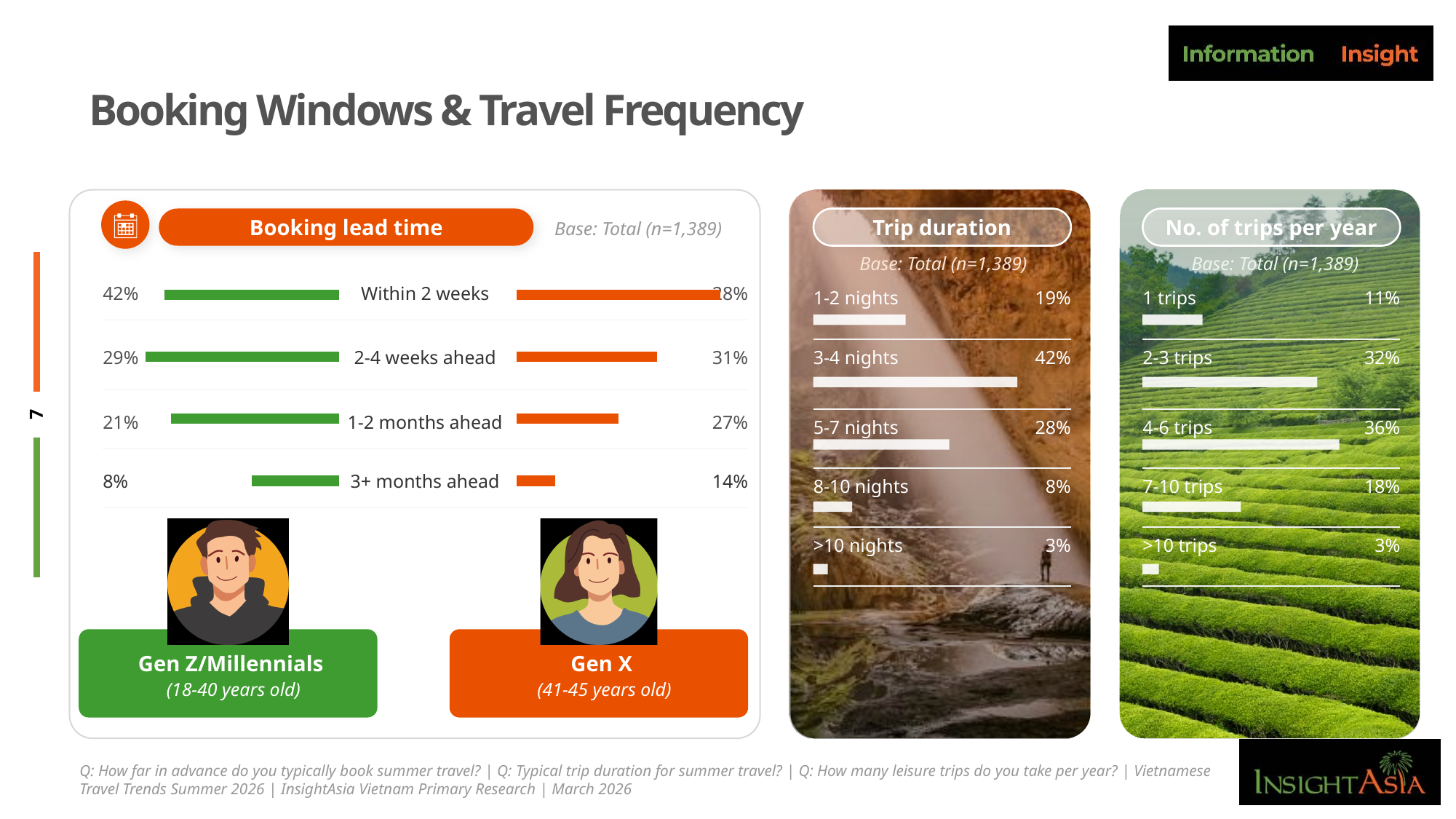
What type of chart is the Booking lead time chart? Bar chart In the Trip duration chart, how many duration categories are shown? 5 In the Trip duration chart, what percentage of respondents take trips of 3-4 nights? 42% In the Booking lead time chart, what percentage of Gen Z/Millennials book within 2 weeks? 42% In the No. of trips per year chart, what is the difference between the shares for 2-3 trips and 1 trips? 21 percentage points In the Booking lead time chart, which group has the larger share for 2-4 weeks ahead, Gen Z/Millennials or Gen X? Gen X In the No. of trips per year chart, what percentage of respondents take 7-10 trips? 18% In the Booking lead time chart, which booking window has the lowest share for Gen Z/Millennials? 3+ months ahead In the Booking lead time chart, what percentage of Gen X book 1-2 months ahead? 27% In the Booking lead time chart, what is the difference between Gen X and Gen Z/Millennials for 3+ months ahead? 6 percentage points In the No. of trips per year chart, which category has the highest share? 4-6 trips In the Trip duration chart, which trip duration has the lowest share? >10 nights